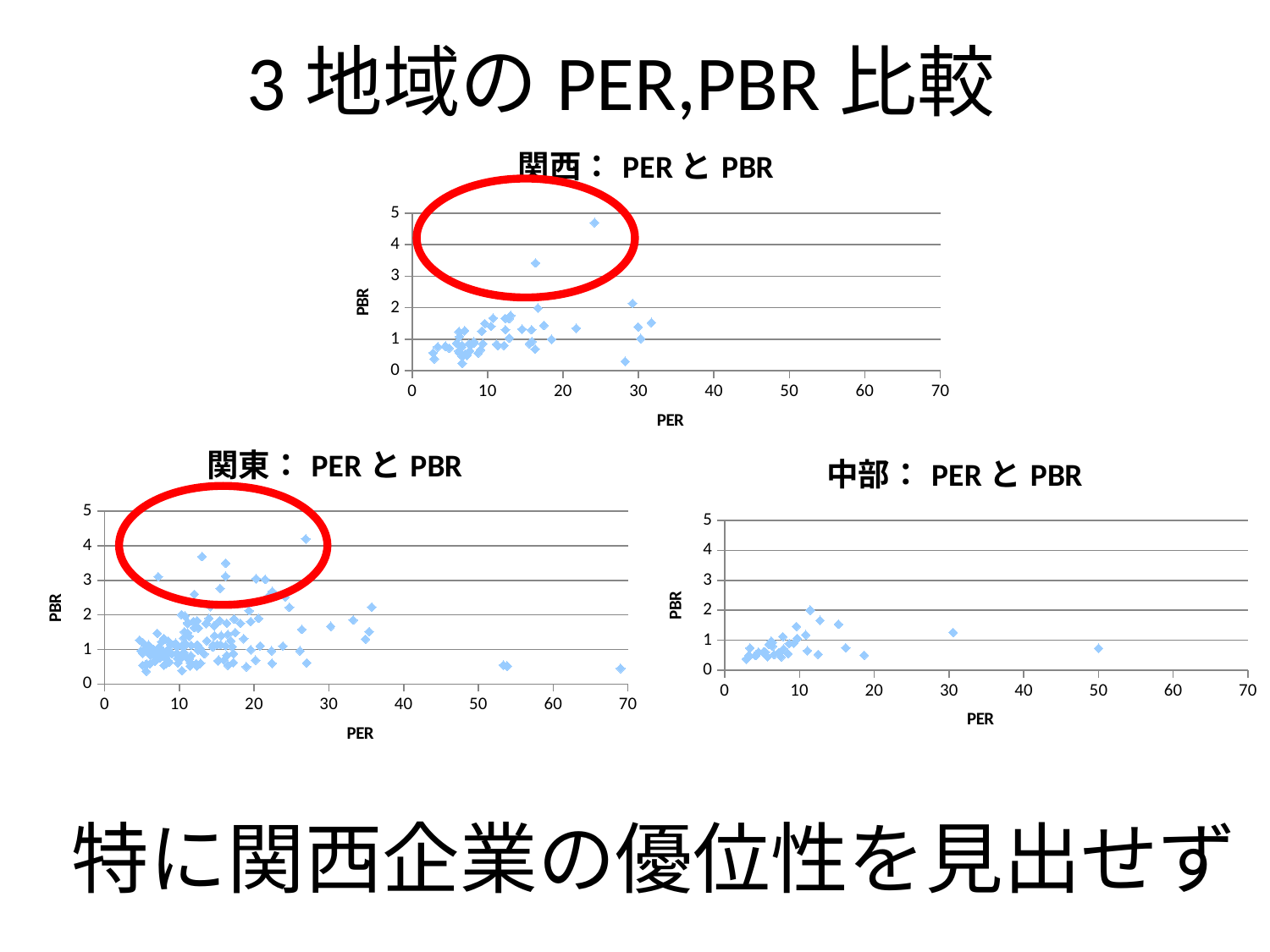
In the 中部： PER と PBR chart, what is the label of the vertical axis? PBR What is the maximum value shown on the PBR axis of the 中部： PER と PBR chart? 5 In the 関西： PER と PBR chart, is the PBR value of the highest point greater or less than 4? greater What kind of chart is the 関西： PER と PBR chart? scatter chart In the 関西： PER と PBR chart, is the PBR value of the point at PER around 16 inside the red circle greater or less than 3? greater What is the maximum value shown on the PER axis of the 関東： PER と PBR chart? 70 In the 中部： PER と PBR chart, is any point plotted with a PBR greater than 3? no Which chart has the most points plotted with PER greater than 40: 関西, 関東, or 中部? 関東 In the 関西： PER と PBR chart, what is the label of the horizontal axis? PER How many charts are shown on the slide? 3